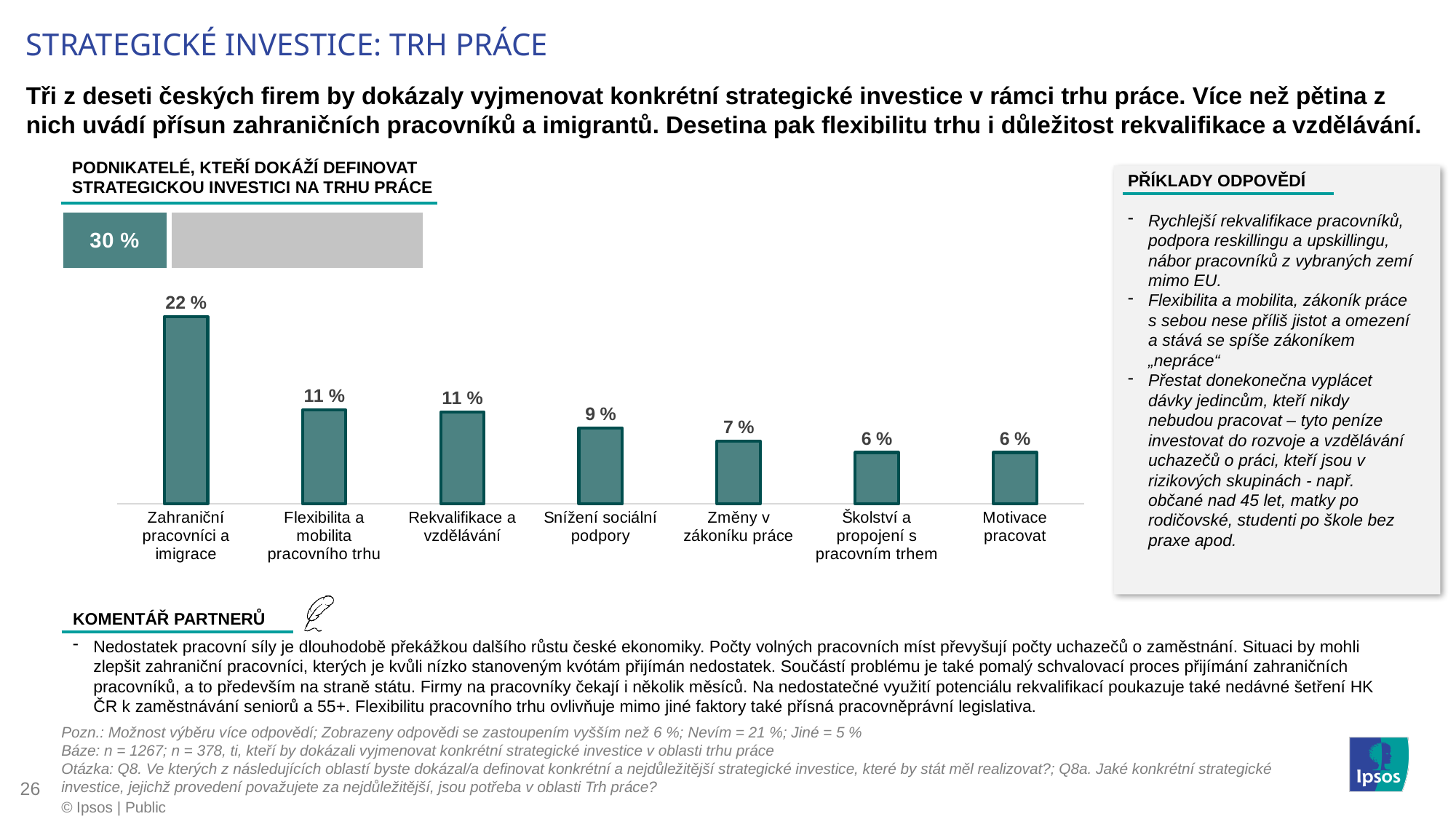
What is the difference between the values for "Zahraniční pracovníci a imigrace" and "Rekvalifikace a vzdělávání"? 11 % What value is shown for "Snížení sociální podpory" in the bar chart? 9 % Which category has the highest value in the bar chart? Zahraniční pracovníci a imigrace What value is shown for "Změny v zákoníku práce" in the bar chart? 7 % Do "Flexibilita a mobilita pracovního trhu" and "Rekvalifikace a vzdělávání" have the same value in the bar chart? Yes, 11 % How many categories are shown in the bar chart? 7 What percentage is shown in the horizontal bar under the heading "PODNIKATELÉ, KTEŘÍ DOKÁŽÍ DEFINOVAT STRATEGICKOU INVESTICI NA TRHU PRÁCE"? 30 % What value is shown for "Zahraniční pracovníci a imigrace" in the bar chart? 22 % What value is shown for "Motivace pracovat" in the bar chart? 6 % Do the values in the bar chart rise or fall from left to right? fall What kind of chart is used to show the categories from "Zahraniční pracovníci a imigrace" to "Motivace pracovat"? bar chart Which is larger: the value for "Snížení sociální podpory" or the value for "Školství a propojení s pracovním trhem"? Snížení sociální podpory